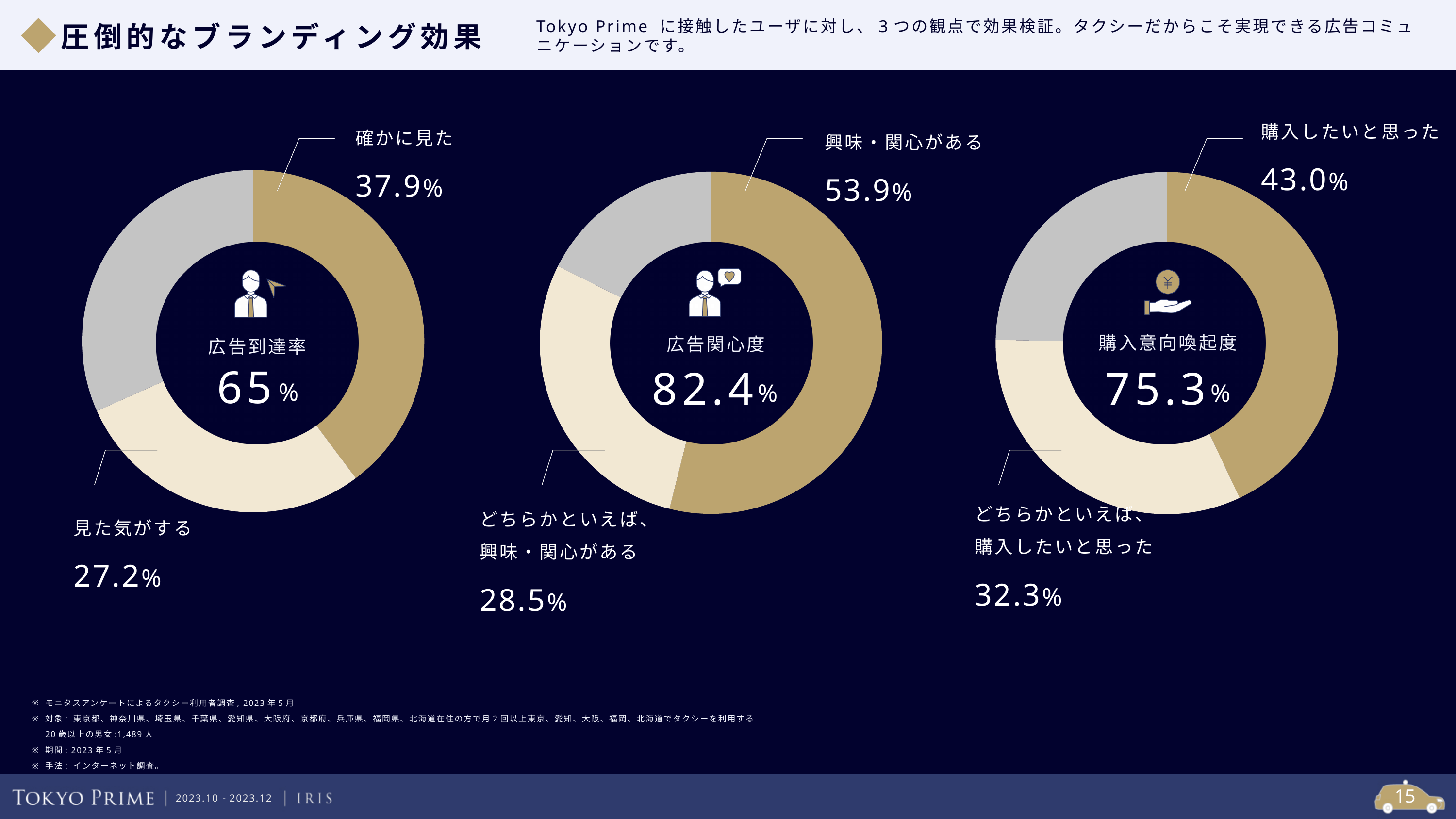
In the 広告到達率 chart (left), what is the difference between 確かに見た and 見た気がする? 10.7% In the 広告関心度 chart (middle), what percentage is shown for 興味・関心がある? 53.9% What is the overall percentage shown in the centre of the 広告関心度 chart (middle)? 82.4% Which of the three charts shows the highest overall centre percentage? 広告関心度 In the 広告到達率 chart (left), what percentage is shown for 確かに見た? 37.9% In the 広告到達率 chart (left), what percentage is shown for 見た気がする? 27.2% What kind of chart is used for 広告到達率 (left)? Donut (pie) chart In the 広告関心度 chart (middle), what is the difference between 興味・関心がある and どちらかといえば、興味・関心がある? 25.4% How many donut charts are shown on the slide? 3 What is the overall percentage shown in the centre of the 購入意向喚起度 chart (right)? 75.3% In the 購入意向喚起度 chart (right), which is larger: 購入したいと思った or どちらかといえば、購入したいと思った? 購入したいと思った In the 購入意向喚起度 chart (right), what percentage is shown for どちらかといえば、購入したいと思った? 32.3%